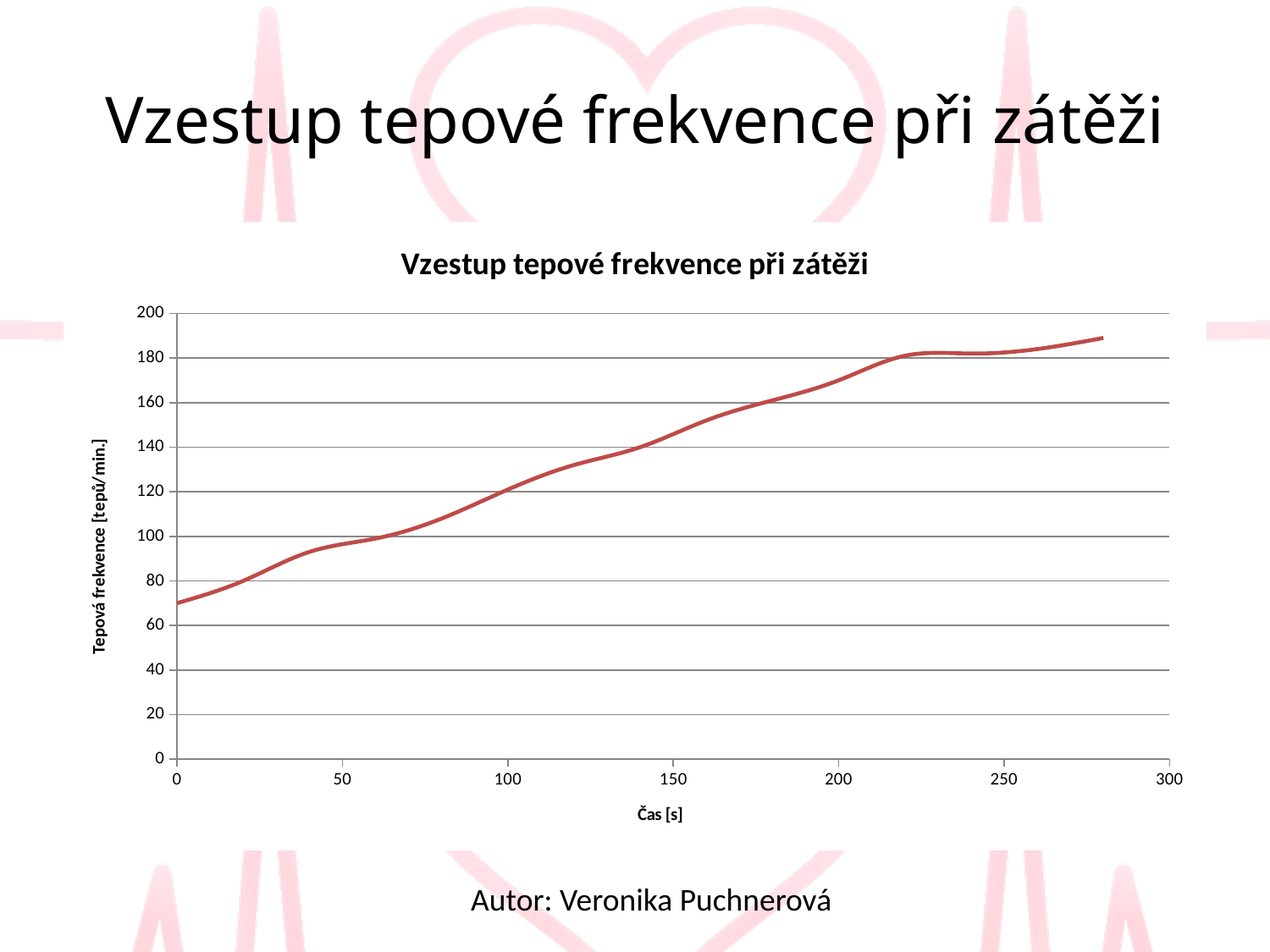
Is the heart rate at 200 s greater or less than 180? less What is the title of the chart? Vzestup tepové frekvence při zátěži Does the heart rate rise or fall as time increases along the x axis? rise What is the label of the vertical axis of the chart? Tepová frekvence [tepů/min.] Is the heart rate at 200 s greater or less than 160? greater Is the heart rate at 150 s greater or less than 160? less What kind of chart is shown on the slide? line chart